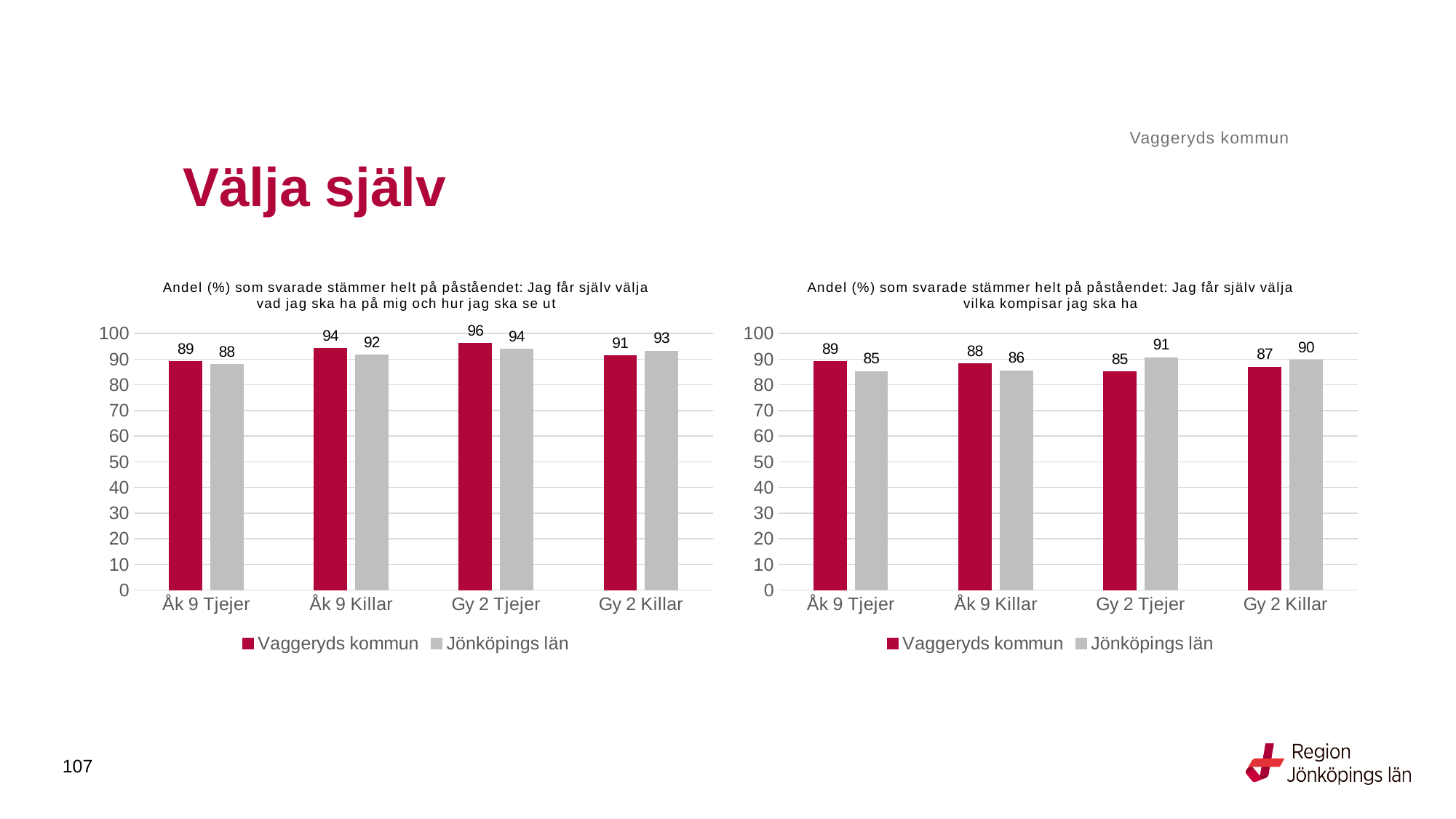
In the left chart (about choosing what to wear and how to look), which category has the highest value for Vaggeryds kommun? Gy 2 Tjejer In the left chart (about choosing what to wear and how to look), what is the value for Jönköpings län for Åk 9 Killar? 92 In the right chart (about choosing which friends to have), what is the difference between Jönköpings län and Vaggeryds kommun for Gy 2 Tjejer? 6 In the left chart (about choosing what to wear and how to look), what is the difference between Vaggeryds kommun for Gy 2 Tjejer and Vaggeryds kommun for Åk 9 Tjejer? 7 In the right chart (about choosing which friends to have), what is the value for Jönköpings län for Gy 2 Killar? 90 In the right chart (about choosing which friends to have), which category has the lowest value for Jönköpings län? Åk 9 Tjejer How many series does the legend of the left chart (about choosing what to wear and how to look) list? 2 In the left chart (about choosing what to wear and how to look), what is the value for Vaggeryds kommun for Gy 2 Tjejer? 96 In the left chart (about choosing what to wear and how to look), which is larger for Gy 2 Killar: Vaggeryds kommun or Jönköpings län? Jönköpings län In the right chart (about choosing which friends to have), what is the value for Vaggeryds kommun for Gy 2 Tjejer? 85 How many categories are shown on the x axis of the right chart (about choosing which friends to have)? 4 What kind of chart is the right chart (about choosing which friends to have)? Bar chart